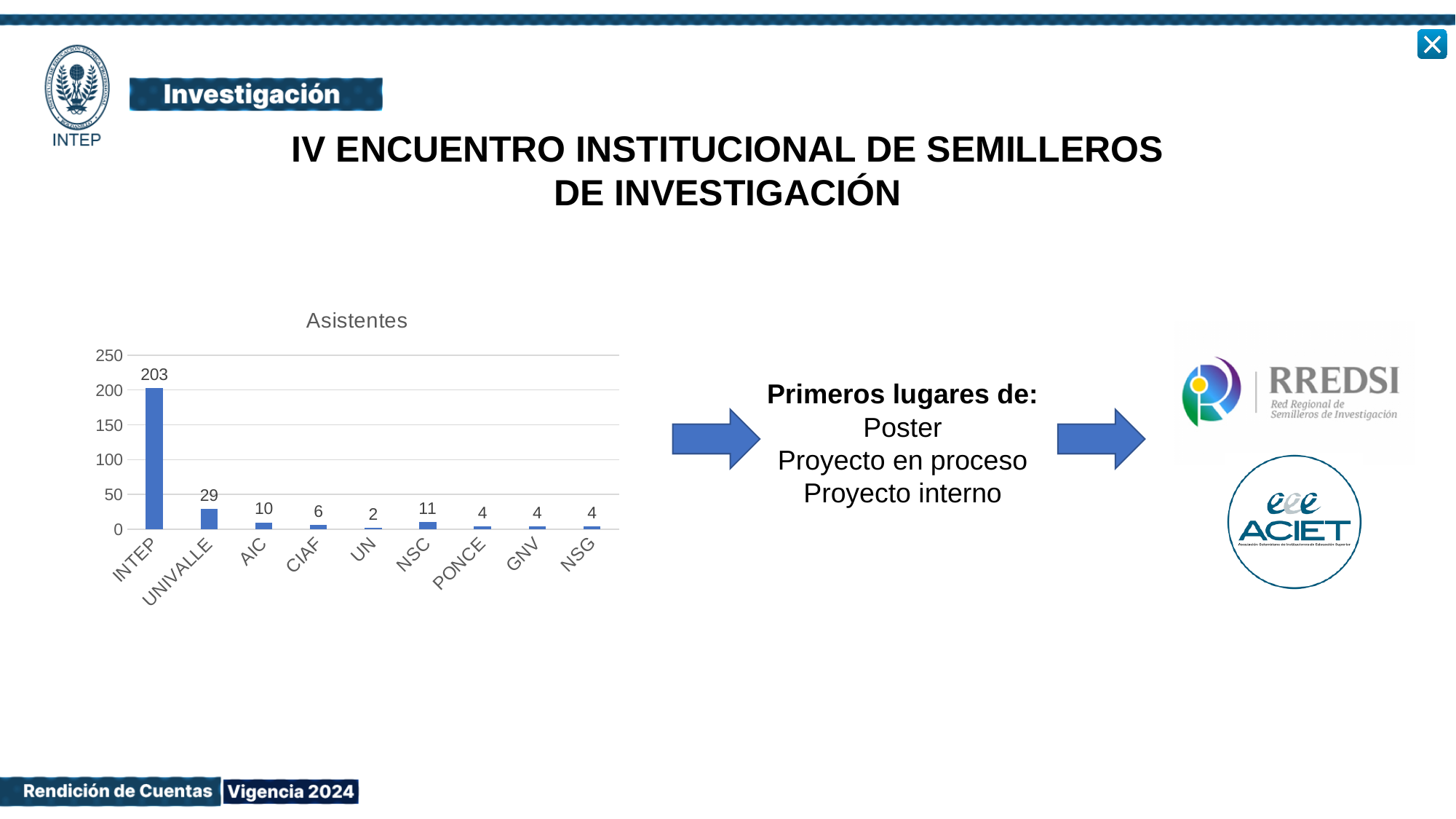
What is the value for UNIVALLE in the Asistentes chart? 29 How many categories are shown in the Asistentes chart? 9 What is the title of the chart on the slide? Asistentes Which category has the lowest value in the Asistentes chart? UN What is the value for INTEP in the Asistentes chart? 203 What kind of chart is the Asistentes chart? bar chart What is the value for NSC in the Asistentes chart? 11 What is the difference between the values for INTEP and UNIVALLE in the Asistentes chart? 174 Is the value for INTEP in the Asistentes chart greater or less than 150? greater What is the difference between the values for NSC and AIC in the Asistentes chart? 1 Which is larger in the Asistentes chart, the value for AIC or the value for CIAF? AIC Which category has the highest value in the Asistentes chart? INTEP